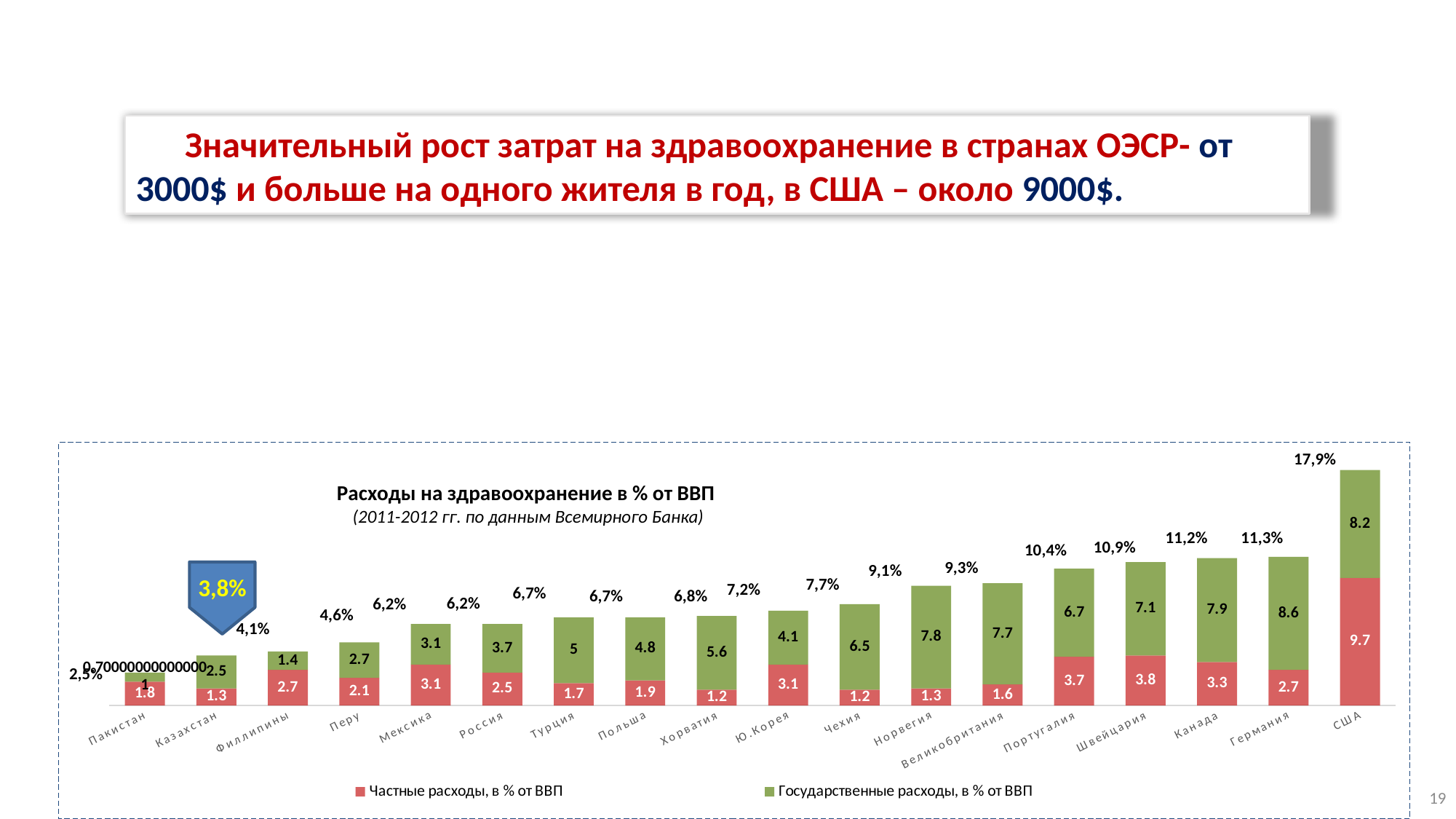
What is the value of Государственные расходы (green segment) for США? 8.2 Which is larger: the Частные расходы value for Ю.Корея or for Чехия? Ю.Корея What is the value of Государственные расходы (green segment) for Норвегия? 7.8 What is the total health expenditure as % of GDP shown for Германия? 11,3% What is the difference between the Государственные расходы values for Канада and Португалия? 1.2 Which country has the highest total health expenditure as % of GDP? США What is the title of the chart? Расходы на здравоохранение в % от ВВП What kind of chart is shown on the slide? Stacked bar chart Which country has the lowest total health expenditure as % of GDP? Пакистан How many series does the chart legend list? 2 What is the value of Частные расходы (red segment) for Швейцария? 3.8 How many countries are shown on the x axis of the chart? 18